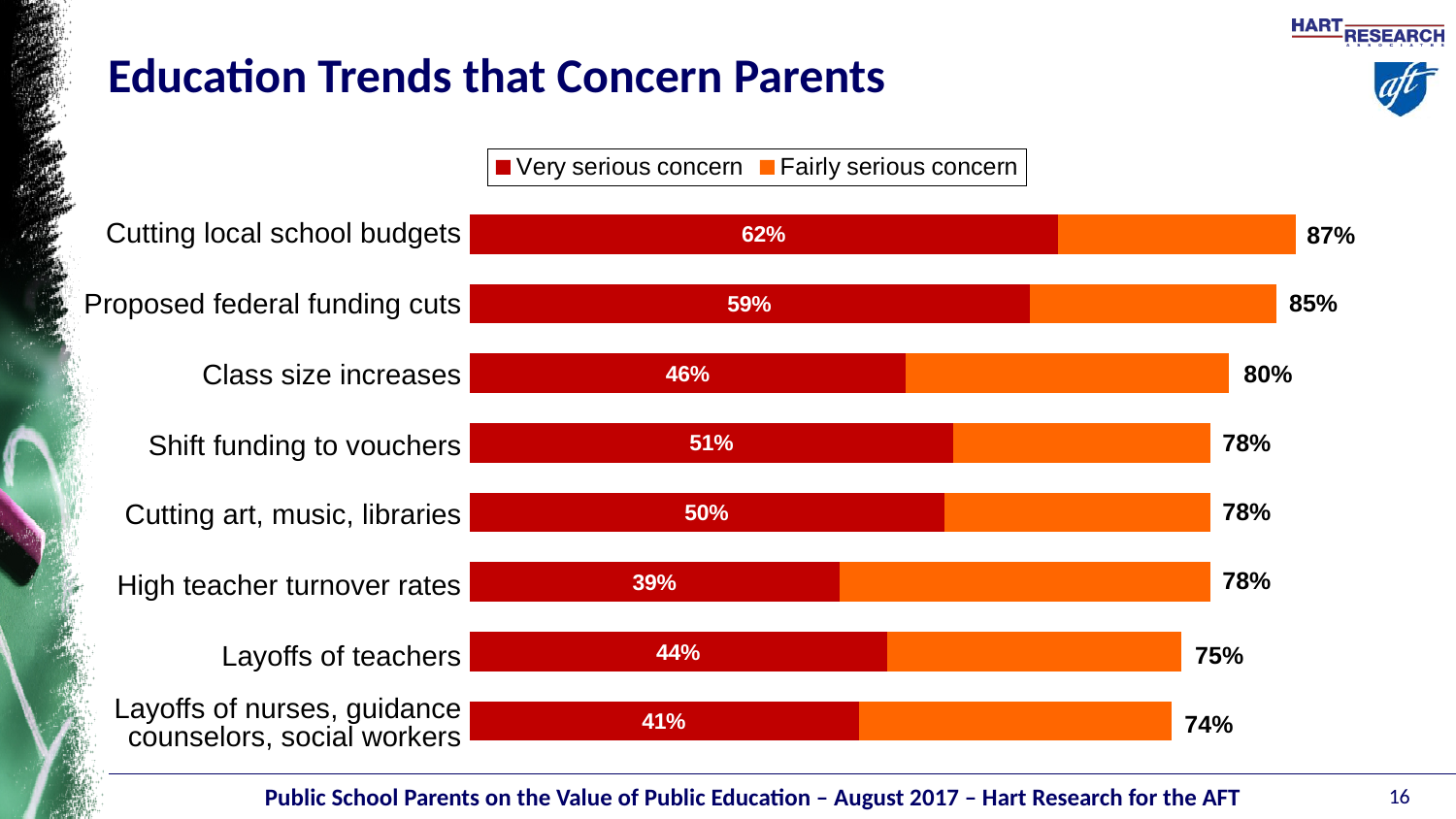
Which education trend has the lowest combined concern percentage? Layoffs of nurses, guidance counselors, social workers Based on the printed labels, what percentage of parents consider cutting local school budgets a fairly serious (but not very serious) concern? 25% What percentage of parents say high teacher turnover rates is a very serious concern? 39% Which has a higher 'very serious concern' percentage: shift funding to vouchers or layoffs of teachers? Shift funding to vouchers What type of chart is shown on the slide? Stacked bar chart What is the difference between the 'very serious concern' percentages for cutting local school budgets and proposed federal funding cuts? 3 percentage points Which education trend has the lowest 'very serious concern' percentage? High teacher turnover rates What percentage of parents say cutting local school budgets is a very serious concern? 62% How many series does the legend list? 2 What is the combined (very serious plus fairly serious) concern percentage for class size increases? 80% Which education trend has the highest combined concern percentage? Cutting local school budgets How many education trends are shown in the chart? 8